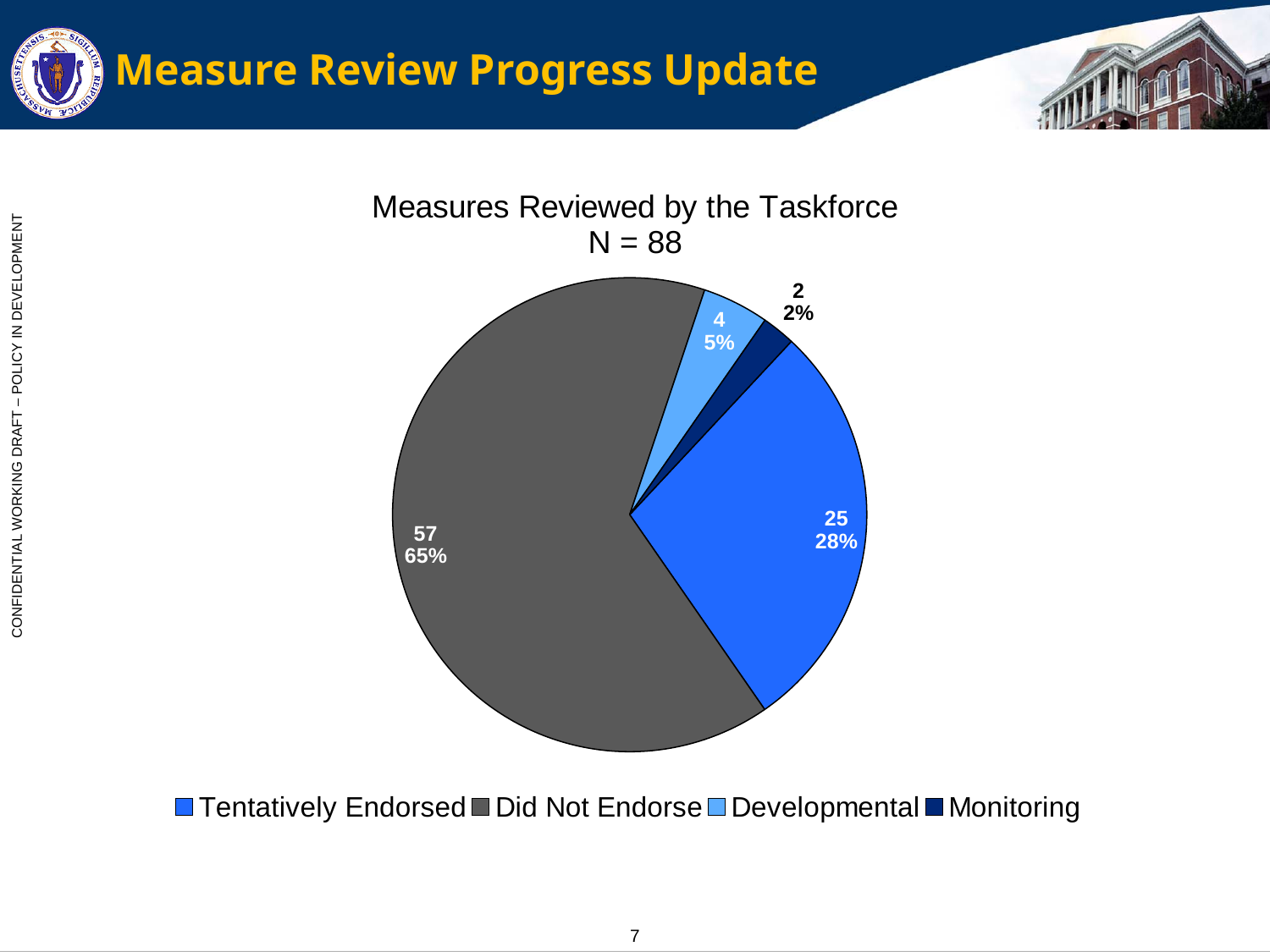
Which category has the largest slice of the pie? Did Not Endorse How many measures fall under Did Not Endorse? 57 What kind of chart is shown on the slide? Pie chart What percentage of measures are in Monitoring? 2% What share of the pie does Did Not Endorse represent? 65% How many measures were Tentatively Endorsed? 25 What is the difference between the number of Did Not Endorse measures and Tentatively Endorsed measures? 32 What is the title of the chart? Measures Reviewed by the Taskforce N = 88 How many categories does the legend list? 4 Which category has the smallest slice of the pie? Monitoring Which is larger, the Developmental slice or the Monitoring slice? Developmental What percentage of measures are Developmental? 5%